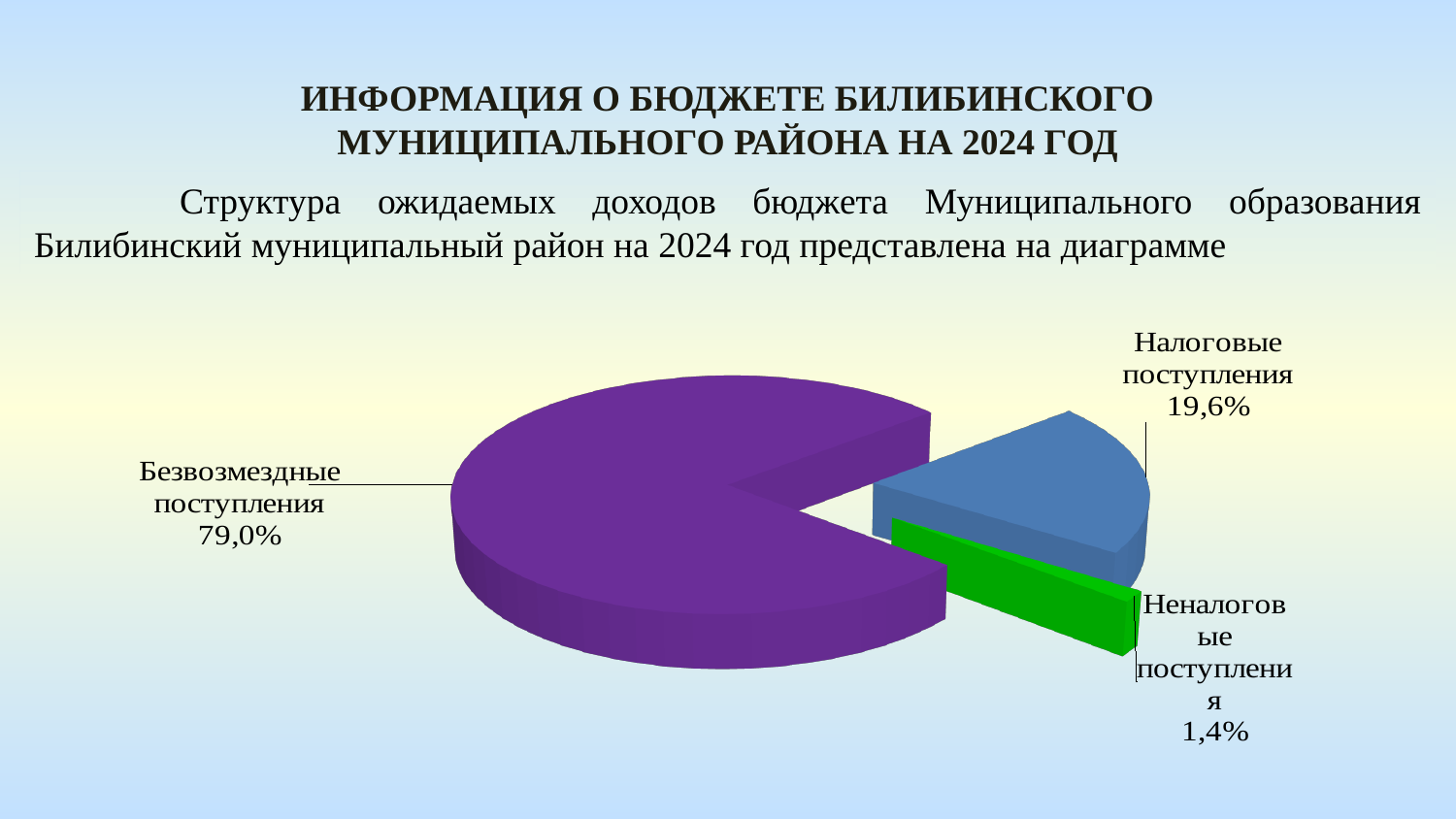
What colour is the slice for Неналоговые поступления? green What share of the pie does Безвозмездные поступления have? 79,0% What is the value shown for Налоговые поступления? 19,6% Which category has the largest slice of the pie? Безвозмездные поступления How many slices does the pie chart have? 3 Which is larger, Налоговые поступления or Неналоговые поступления? Налоговые поступления Which category has the smallest slice of the pie? Неналоговые поступления What is the difference between the shares of Налоговые поступления and Неналоговые поступления? 18,2% What colour is the slice for Безвозмездные поступления? purple What is the value shown for Неналоговые поступления? 1,4% What is the difference between the shares of Безвозмездные поступления and Налоговые поступления? 59,4% What kind of chart is shown on the slide? pie chart